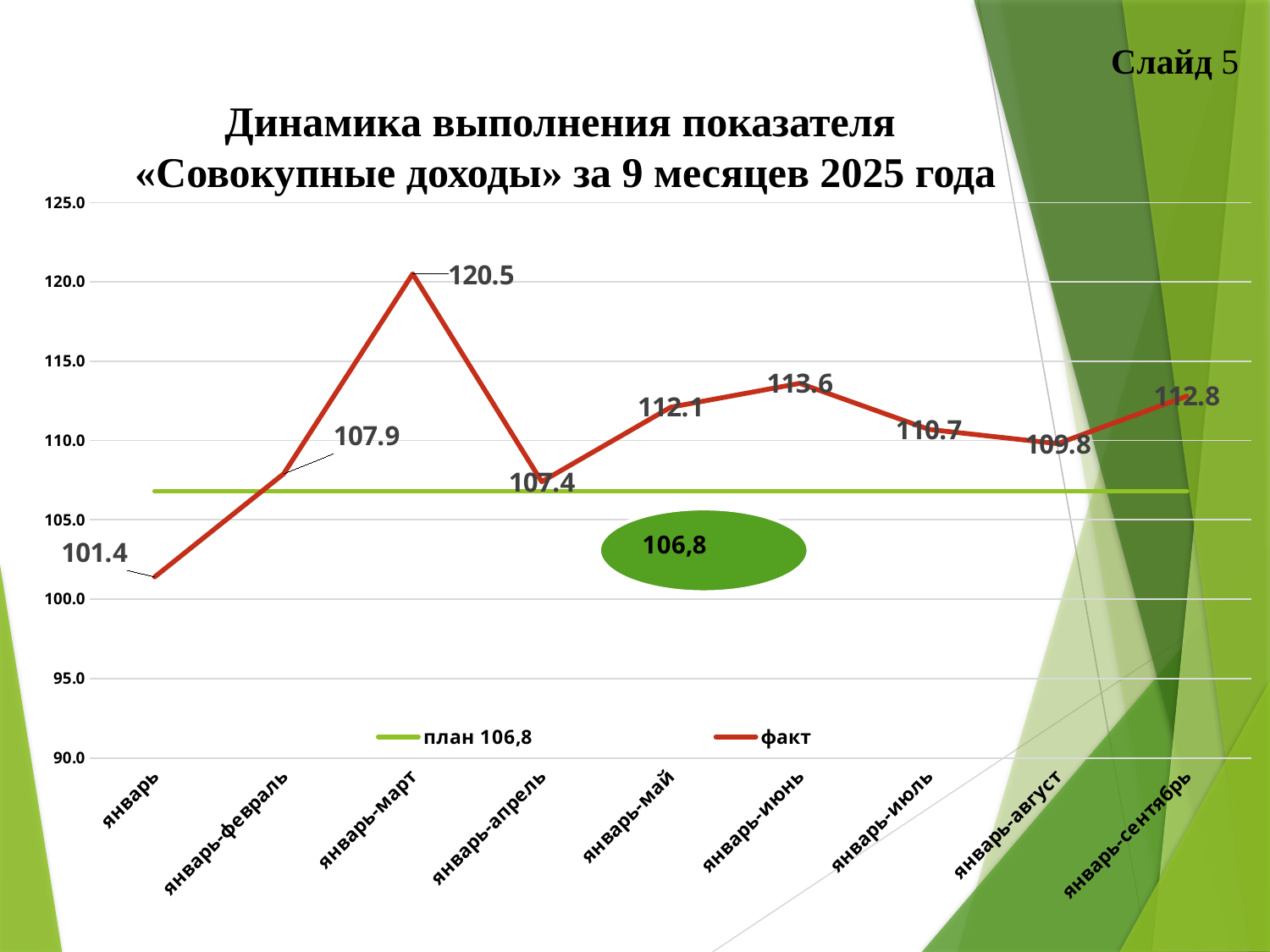
What type of chart is shown on the slide? line chart Which is larger, the факт value for январь-май or for январь-июль? январь-май Which period has the highest факт value? январь-март How many periods are shown on the x axis? 9 What is the value of факт for январь-сентябрь? 112.8 What is the value of факт for январь-март? 120.5 What is the value of факт for январь-июнь? 113.6 What is the value of факт for январь? 101.4 Which period has the lowest факт value? январь How many series does the legend list? 2 Is the факт value for январь greater or less than 105.0? less What is the difference between the факт values for январь-март and январь-апрель? 13.1